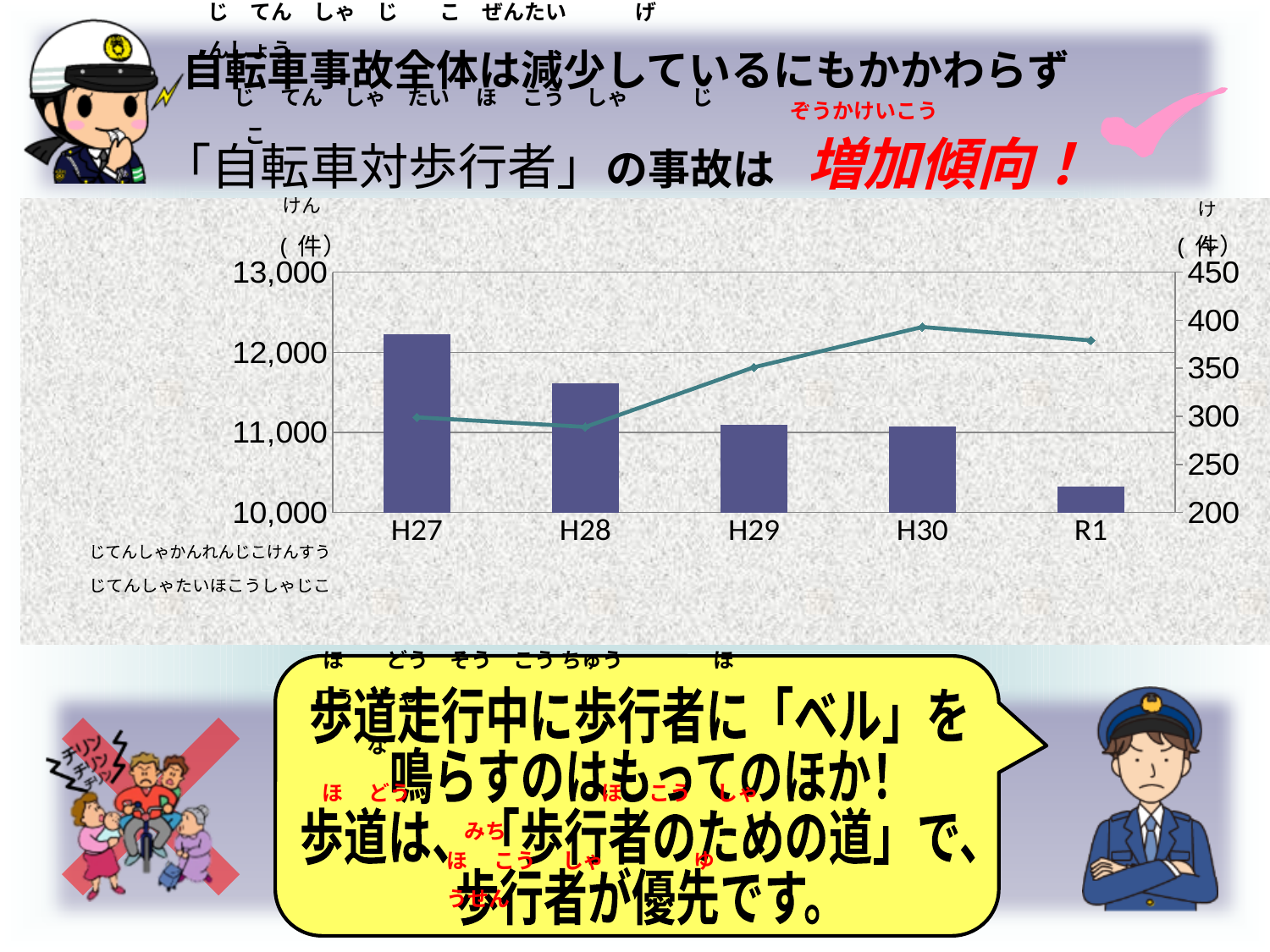
How many categories are shown on the x axis of the chart? 5 Do the bar values rise or fall from H27 to R1? Fall What kind of chart is shown on the slide? A combined bar and line chart Is the bar value for R1 greater or less than 11,000? less Which is larger, the bar value for H27 or the bar value for H28? H27 What is the highest tick value shown on the right-hand axis of the chart? 450 Is the line value for H30 greater or less than 350 on the right axis? greater Is the line value for H27 greater or less than 350 on the right axis? less Which category has the tallest bar in the chart? H27 Which category has the shortest bar in the chart? R1 At which category does the line series reach its highest point? H30